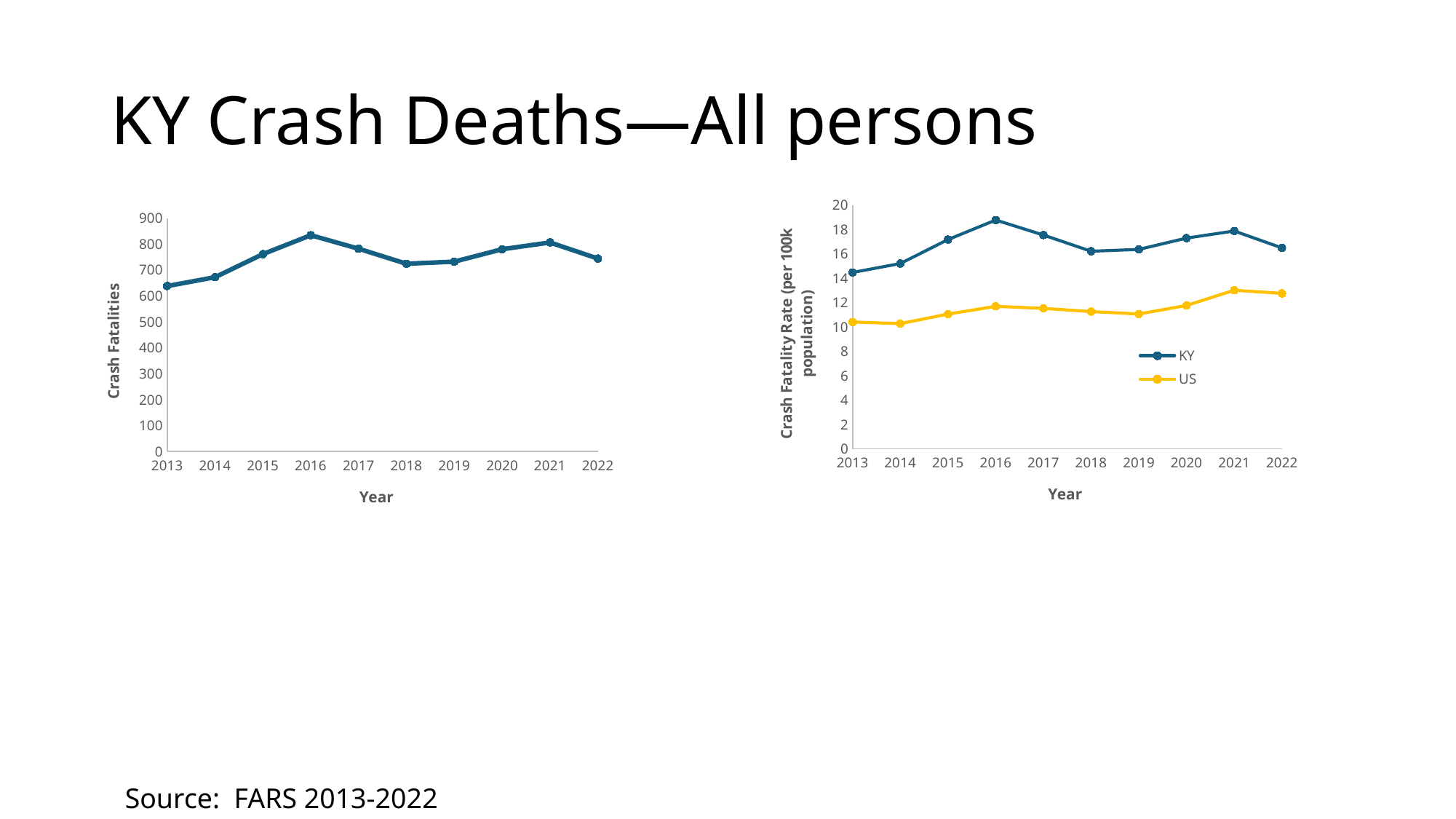
How many series does the legend list on the right chart (Crash Fatality Rate)? 2 How many years are plotted on the left chart (Crash Fatalities)? 10 On the right chart (Crash Fatality Rate), is the KY value for 2013 greater or less than 16? less On the left chart (Crash Fatalities), which year has the highest value? 2016 On the left chart (Crash Fatalities), do values rise or fall from 2013 to 2016? rise On the left chart (Crash Fatalities), which year has the lowest value? 2013 On the right chart (Crash Fatality Rate), which year has the highest KY value? 2016 What kind of chart is the left chart (Crash Fatalities)? line chart On the left chart (Crash Fatalities), is the value for 2013 greater or less than 700? less On the right chart (Crash Fatality Rate), is the US value for 2021 greater or less than 12? greater On the right chart (Crash Fatality Rate), which series has the larger value in 2016, KY or US? KY